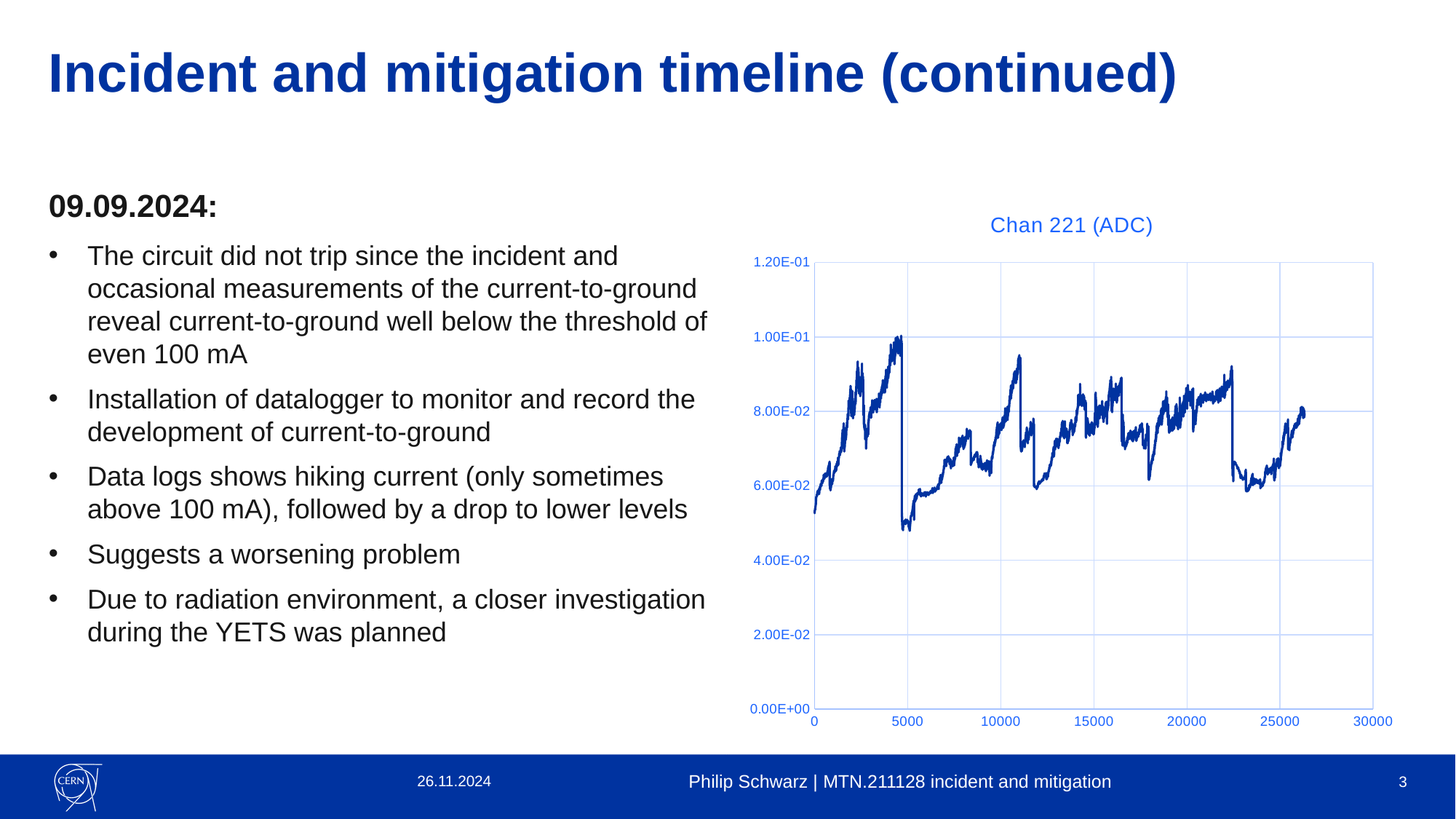
Is the value of the line at x = 0 greater or less than 6.00E-02? less What is the highest tick value shown on the y axis of the chart? 1.20E-01 Is the value of the line just after x = 5000 greater or less than 6.00E-02? less How many data series are plotted in the chart? 1 Is the value of the line at about x = 11000 greater or less than 8.00E-02? greater Does the line rise or fall between x = 0 and about x = 4500? rise What kind of chart is shown on the slide? line chart What is the title of the chart? Chan 221 (ADC)